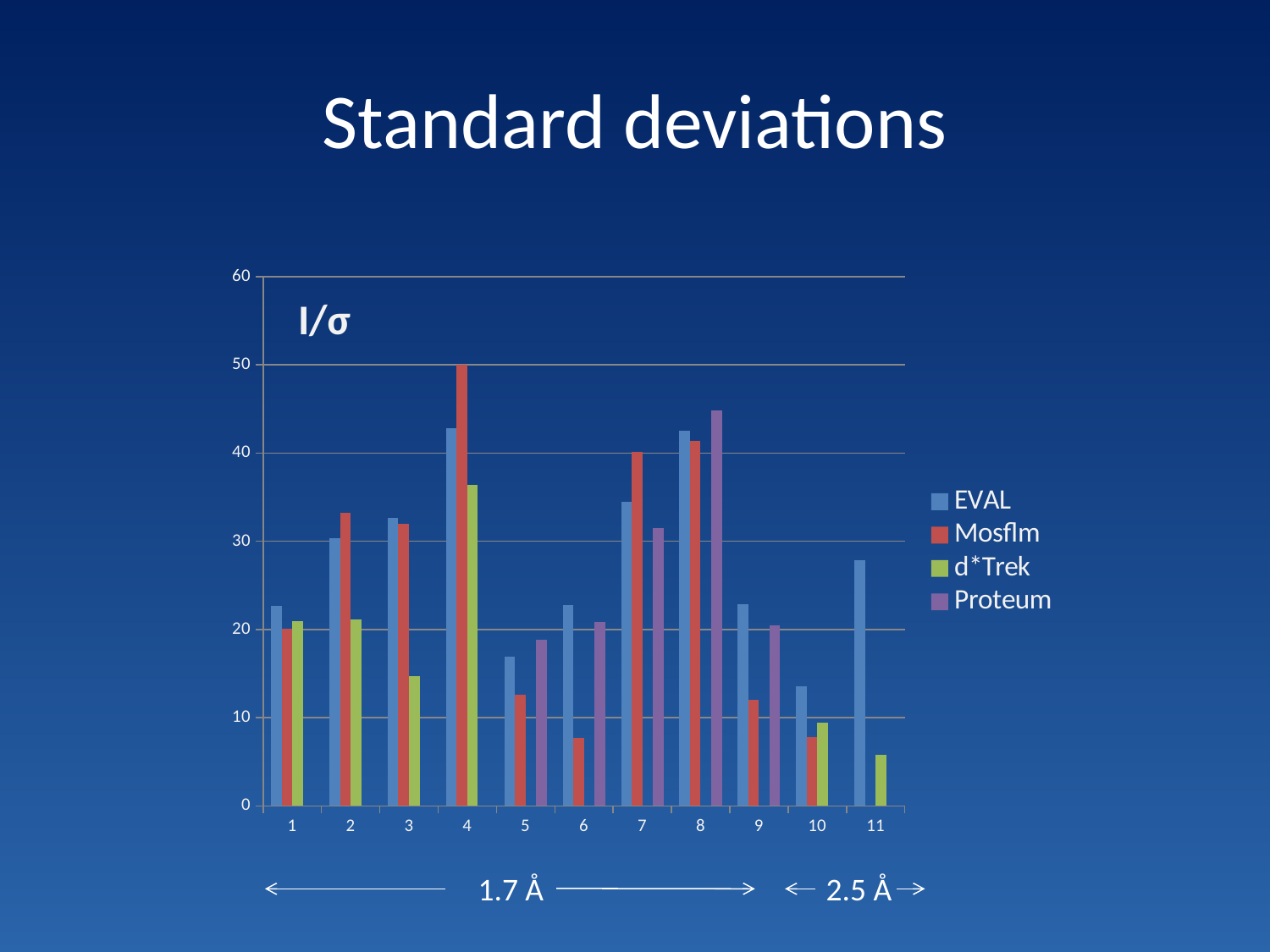
What label is written inside the plot area near the top of the y axis? I/σ How many series does the legend list? 4 For category 6, which is larger: the EVAL value or the Mosflm value? EVAL For category 4, which is larger: the EVAL value or the Mosflm value? Mosflm What kind of chart is shown on the slide? bar chart Is the EVAL value for category 11 greater or less than 20? greater Is the Mosflm value for category 4 greater or less than 40? greater For which category is the Proteum value highest? 8 For which category is the d*Trek value lowest? 11 Is the d*Trek value for category 11 greater or less than 10? less How many categories are shown along the x axis? 11 For which category is the Mosflm value highest? 4